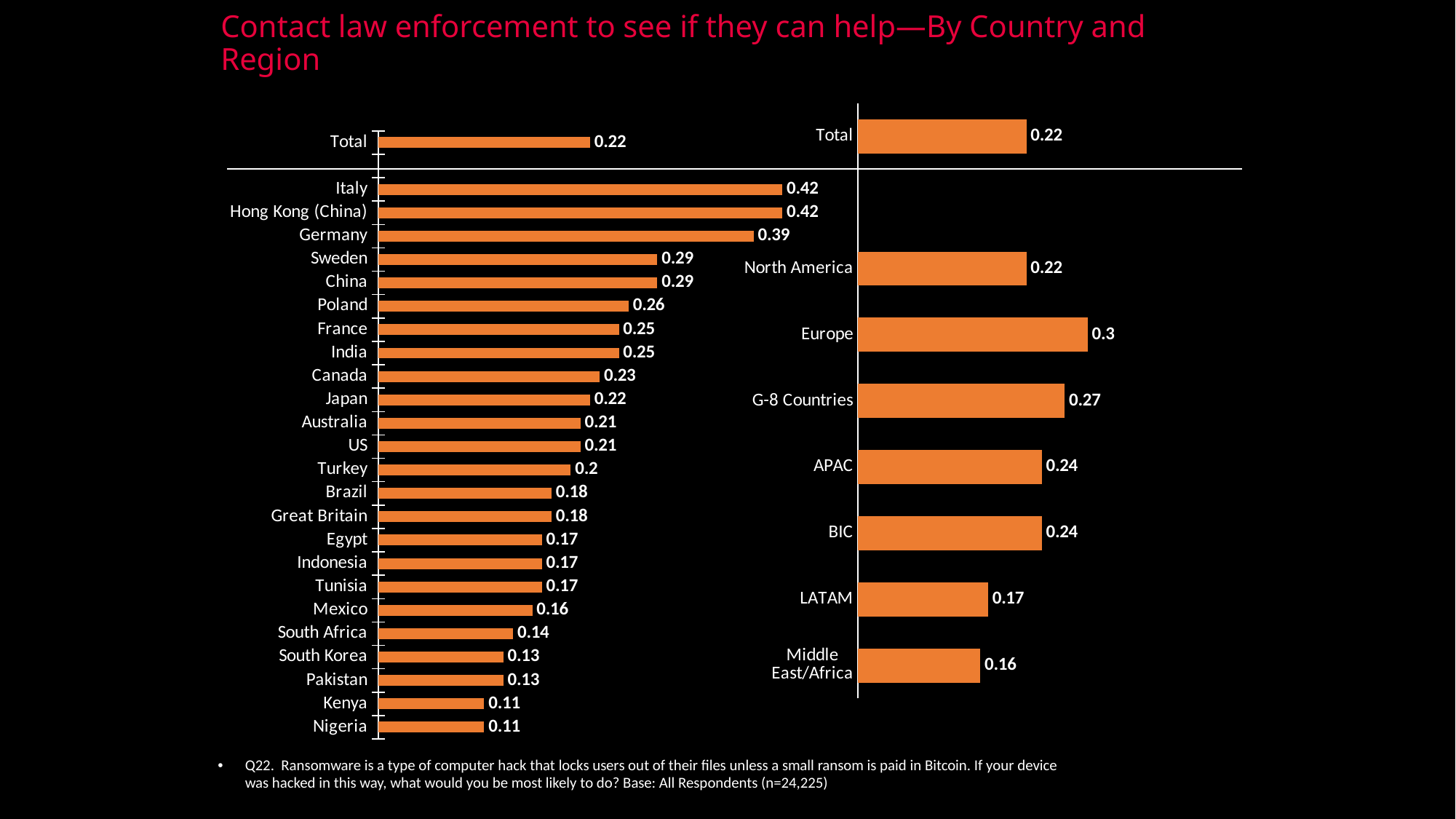
In the left chart (by country), what is the value for Mexico? 0.16 In the right chart (by region), which region has the highest value? Europe In the right chart (by region), what is the difference between the values for G-8 Countries and North America? 0.05 In the right chart (by region), what is the value for LATAM? 0.17 In the left chart (by country), which has the larger value, Sweden or Poland? Sweden In the right chart (by region), what is the value for Europe? 0.3 In the left chart (by country), what is the difference between the values for Italy and Canada? 0.19 In the right chart (by region), which region has the lowest value? Middle East/Africa In the left chart (by country), what is the value for Germany? 0.39 In the right chart (by region), how many regions are listed below the Total bar? 7 What type of chart is used on the left side of the slide? Bar chart In the left chart (by country), how many countries are listed below the Total bar? 24